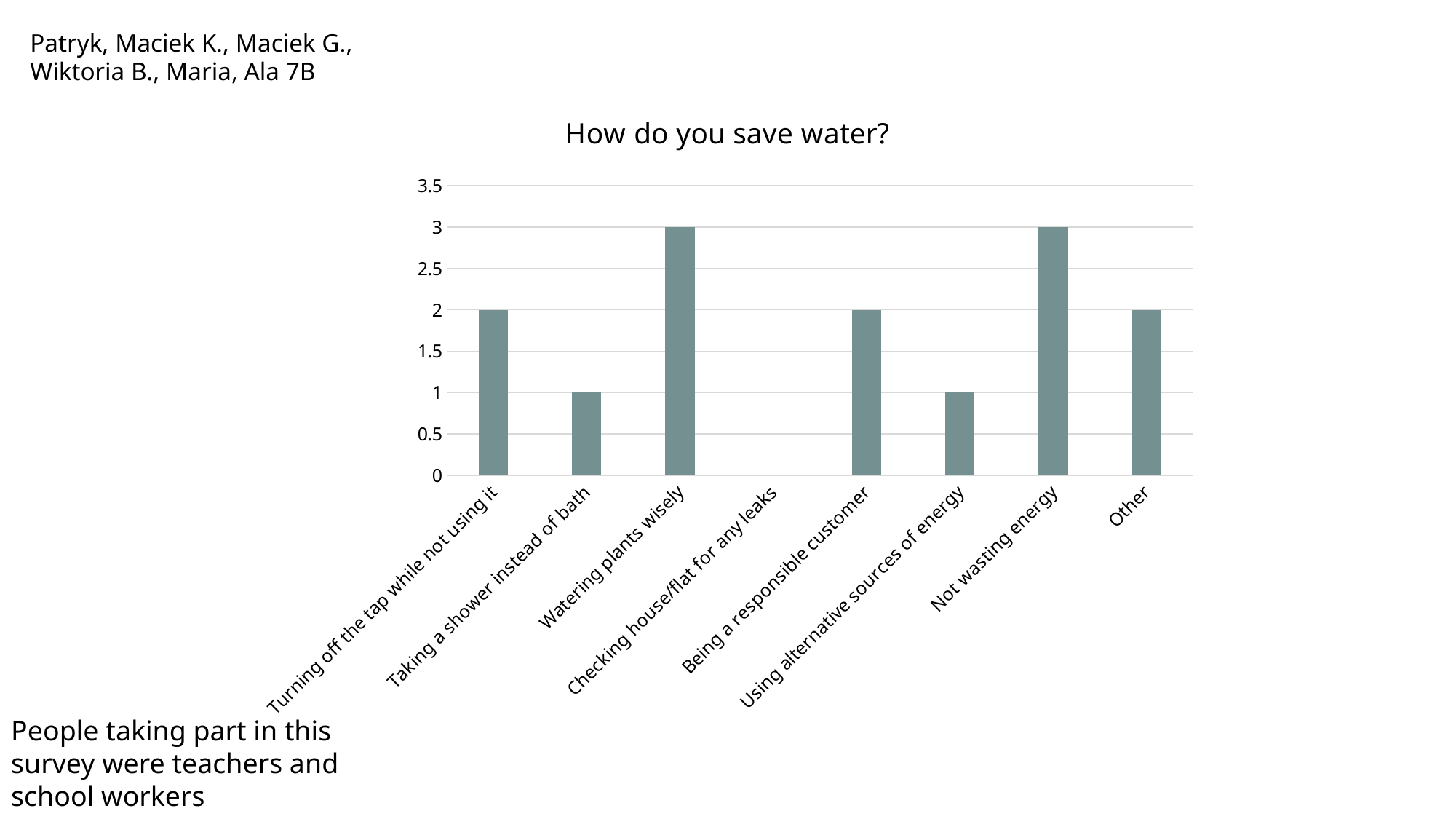
What is the difference between the value for 'Watering plants wisely' and the value for 'Taking a shower instead of bath'? 2 Which is larger, the value for 'Being a responsible customer' or the value for 'Using alternative sources of energy'? Being a responsible customer What is the value for 'Not wasting energy'? 3 What is the value for 'Checking house/flat for any leaks'? 0 How many categories are shown on the x axis of the chart? 8 What is the value for 'Taking a shower instead of bath'? 1 What is the title of the chart? How do you save water? What kind of chart is shown on the slide? bar chart What is the value for 'Turning off the tap while not using it'? 2 Which category has the lowest value? Checking house/flat for any leaks Is the value for 'Other' greater or less than 1? greater What is the value for 'Watering plants wisely'? 3